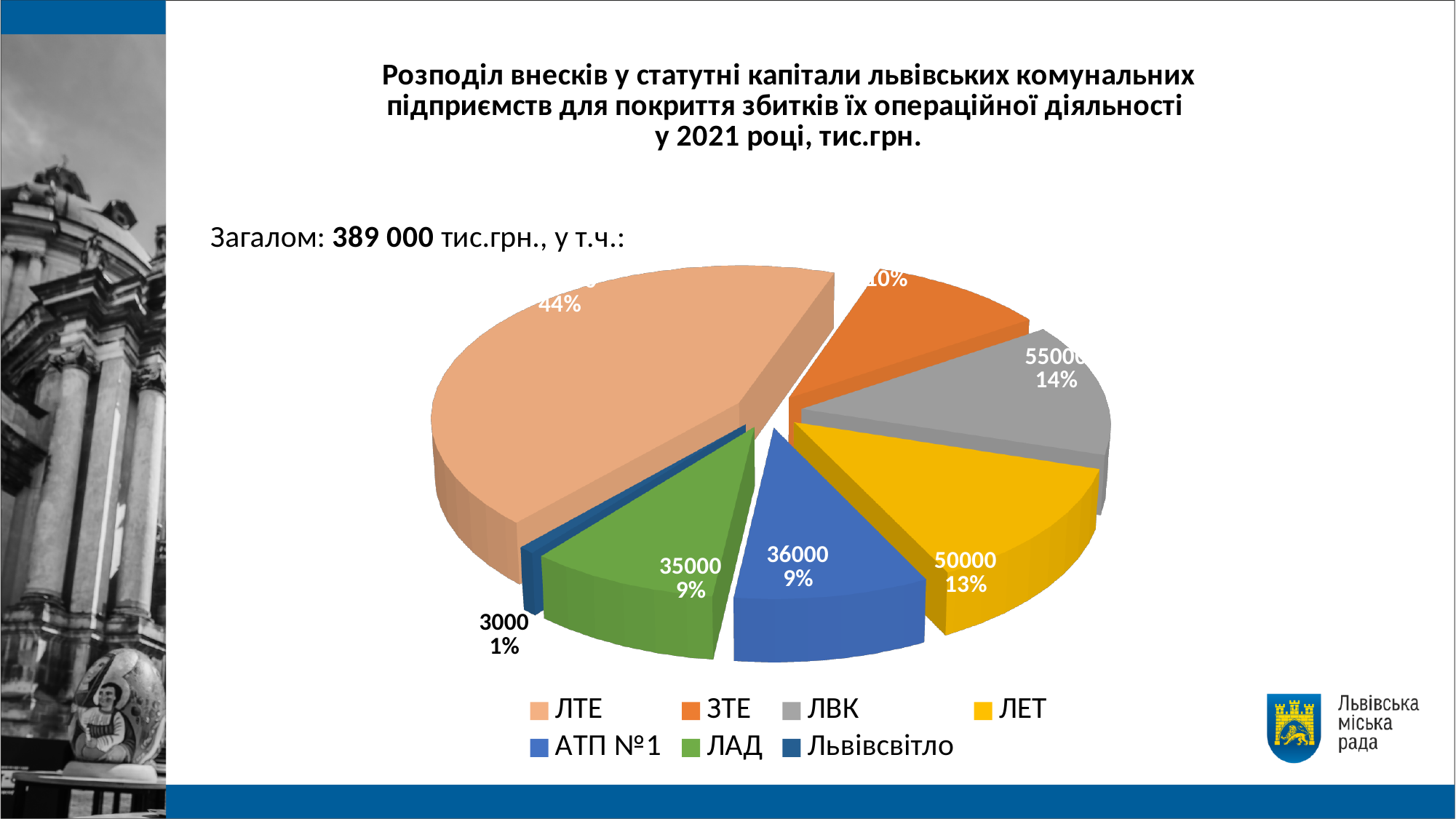
What is the value for ЛАД in the pie chart? 35000 Which category has the smallest slice of the pie? Львівсвітло What is the value for АТП №1 in the pie chart? 36000 What is the value for Львівсвітло in the pie chart? 3000 What is the difference between the values for ЛЕТ and ЛАД? 15000 What kind of chart is shown on the slide? pie chart What share of the pie does ЛТЕ account for? 44% What is the value for ЛЕТ in the pie chart? 50000 How many categories does the legend of the pie chart list? 7 What share of the pie does ЛВК account for? 14% Which category has the largest slice of the pie? ЛТЕ What share of the pie does ЗТЕ account for? 10%